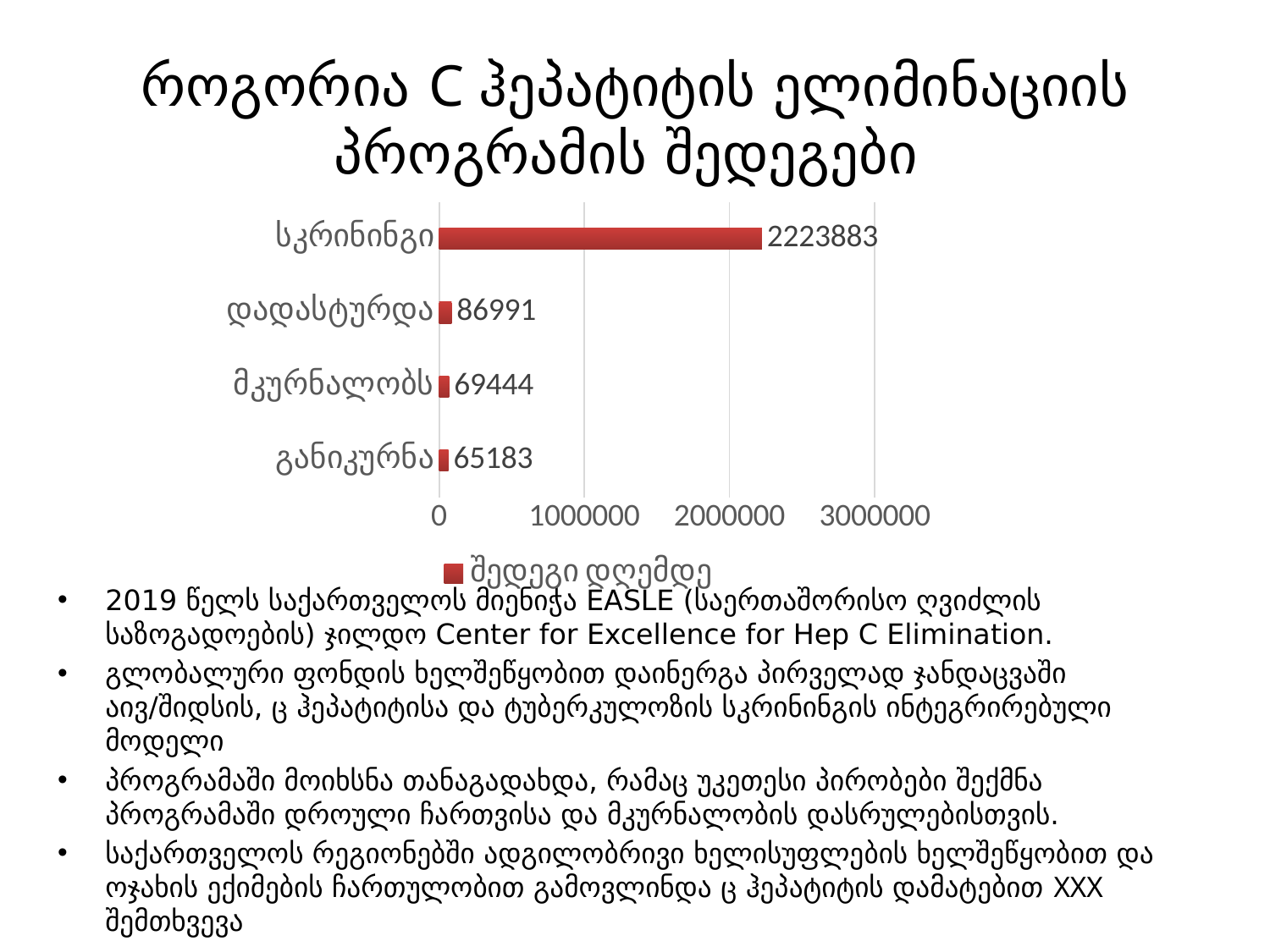
What is the value for დადასტურდა? 86991 What is the value for განიკურნა? 65183 How many categories are shown in the chart? 4 Which is larger, the value for დადასტურდა or the value for განიკურნა? დადასტურდა What is the difference between the values for დადასტურდა and მკურნალობს? 17547 What is the value for სკრინინგი? 2223883 Which category has the lowest value? განიკურნა Is the value for სკრინინგი greater or less than 2000000? greater What is the difference between the values for მკურნალობს and განიკურნა? 4261 What is the value for მკურნალობს? 69444 Which category has the highest value? სკრინინგი What kind of chart is shown on the slide? bar chart